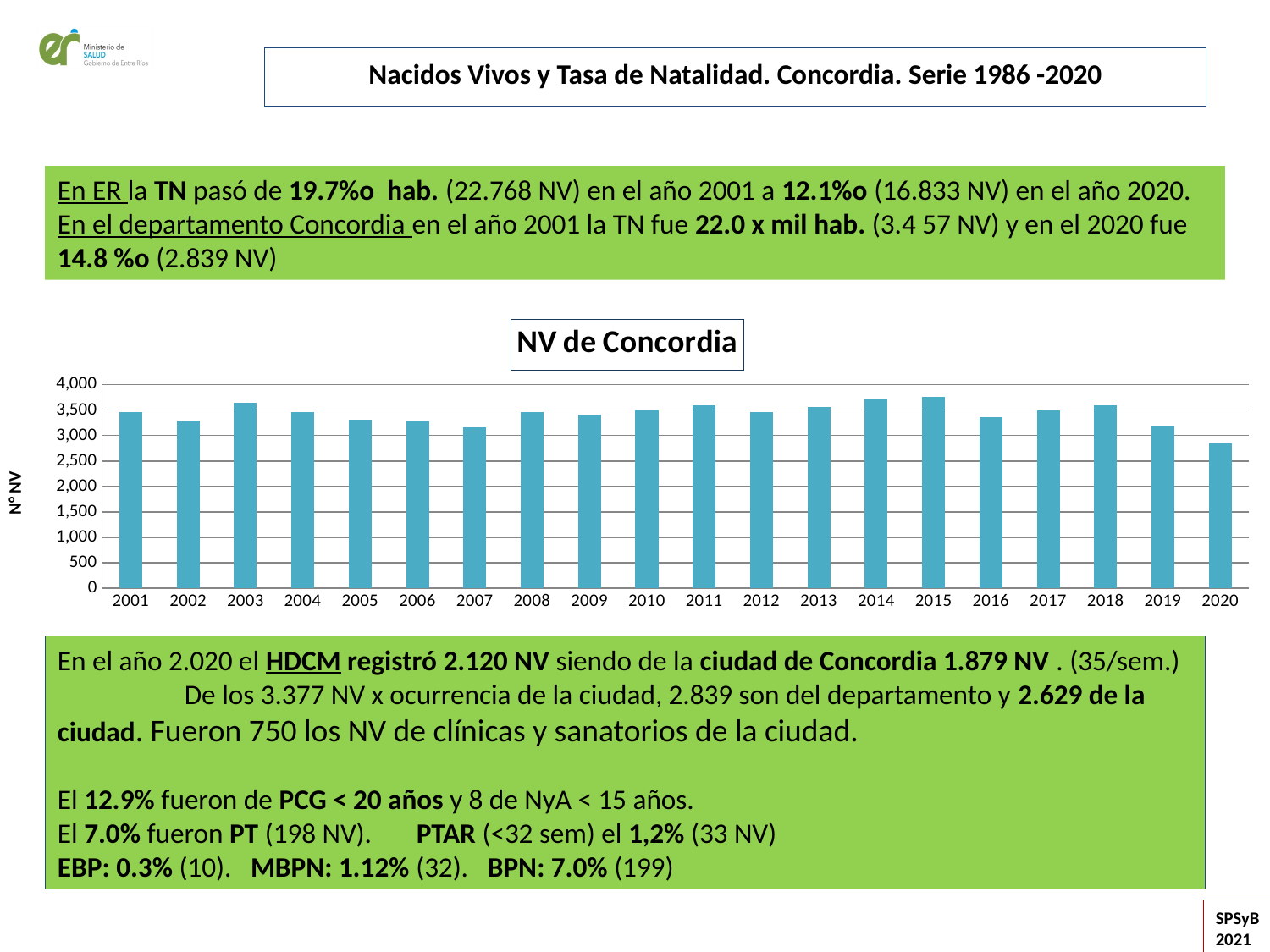
Is the value for 2020 on the 'NV de Concordia' chart greater or less than 3,000? less On the 'NV de Concordia' chart, do the values rise or fall from 2015 to 2020? fall What is the label on the vertical axis of the 'NV de Concordia' chart? N° NV On the 'NV de Concordia' chart, which year has more NV, 2019 or 2020? 2019 Which year has the highest number of NV on the 'NV de Concordia' chart? 2015 On the 'NV de Concordia' chart, which year has more NV, 2002 or 2003? 2003 Is the value for 2015 on the 'NV de Concordia' chart greater or less than 3,500? greater What kind of chart is the 'NV de Concordia' chart? bar chart How many years are plotted on the 'NV de Concordia' chart? 20 Which year has the lowest number of NV on the 'NV de Concordia' chart? 2020 Is the value for 2007 on the 'NV de Concordia' chart greater or less than 3,000? greater